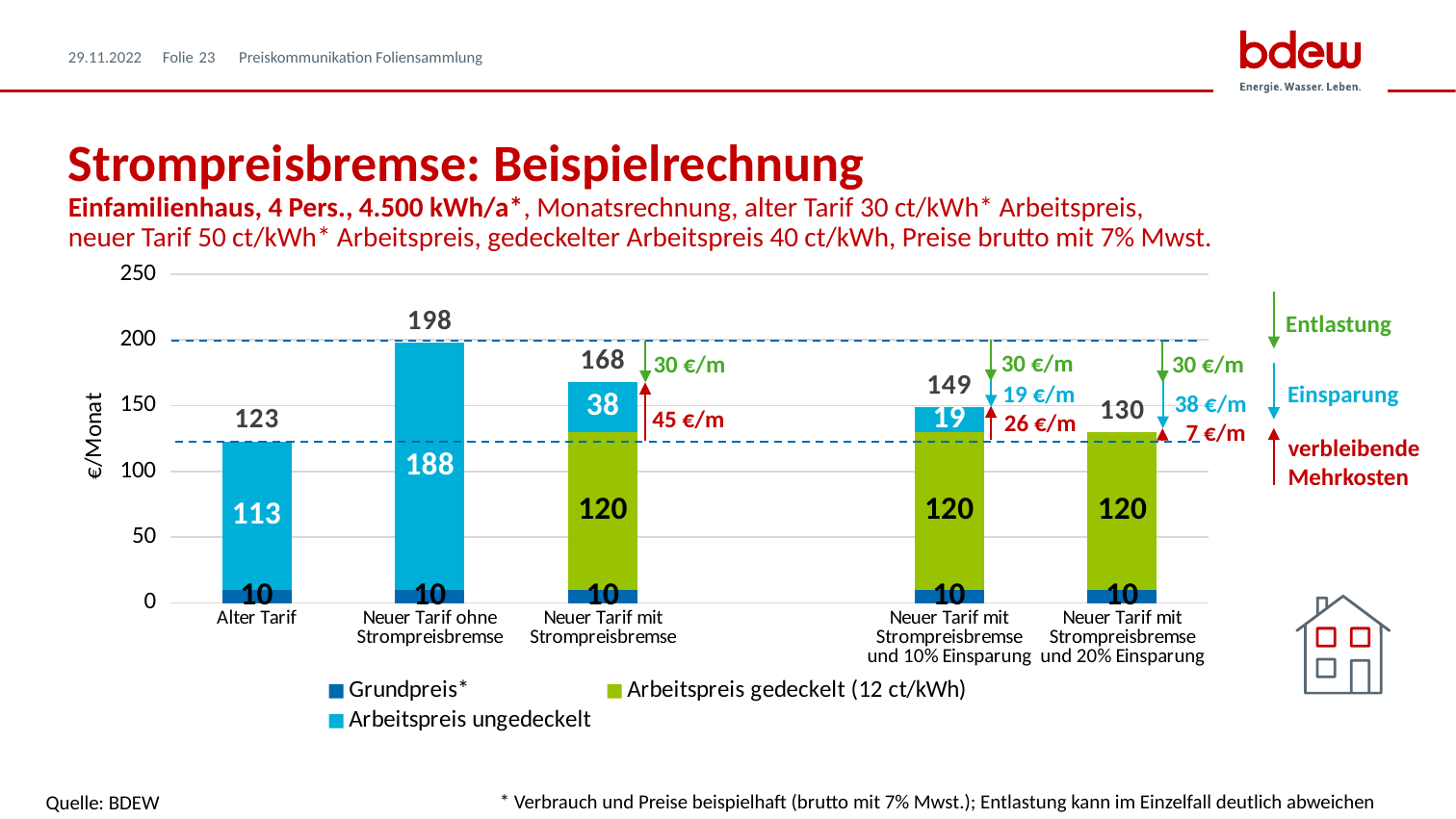
Which category has the highest total monthly cost? Neuer Tarif ohne Strompreisbremse Which is larger: the total for "Neuer Tarif mit Strompreisbremse und 10% Einsparung" or the total for "Neuer Tarif mit Strompreisbremse und 20% Einsparung"? Neuer Tarif mit Strompreisbremse und 10% Einsparung What is the value of the "Grundpreis*" segment for "Alter Tarif"? 10 What is the value of the "Arbeitspreis gedeckelt (12 ct/kWh)" segment for "Neuer Tarif mit Strompreisbremse und 20% Einsparung"? 120 How many categories are shown on the x axis of the chart? 5 What is the value of the "Arbeitspreis ungedeckelt" segment for "Neuer Tarif mit Strompreisbremse"? 38 Which category has the lowest total monthly cost? Alter Tarif What kind of chart is shown on the slide? Stacked bar chart What is the total monthly cost shown for "Neuer Tarif ohne Strompreisbremse"? 198 How many series does the chart legend list? 3 What is the difference between the totals for "Neuer Tarif ohne Strompreisbremse" and "Neuer Tarif mit Strompreisbremse"? 30 What is the total monthly cost shown for "Alter Tarif"? 123